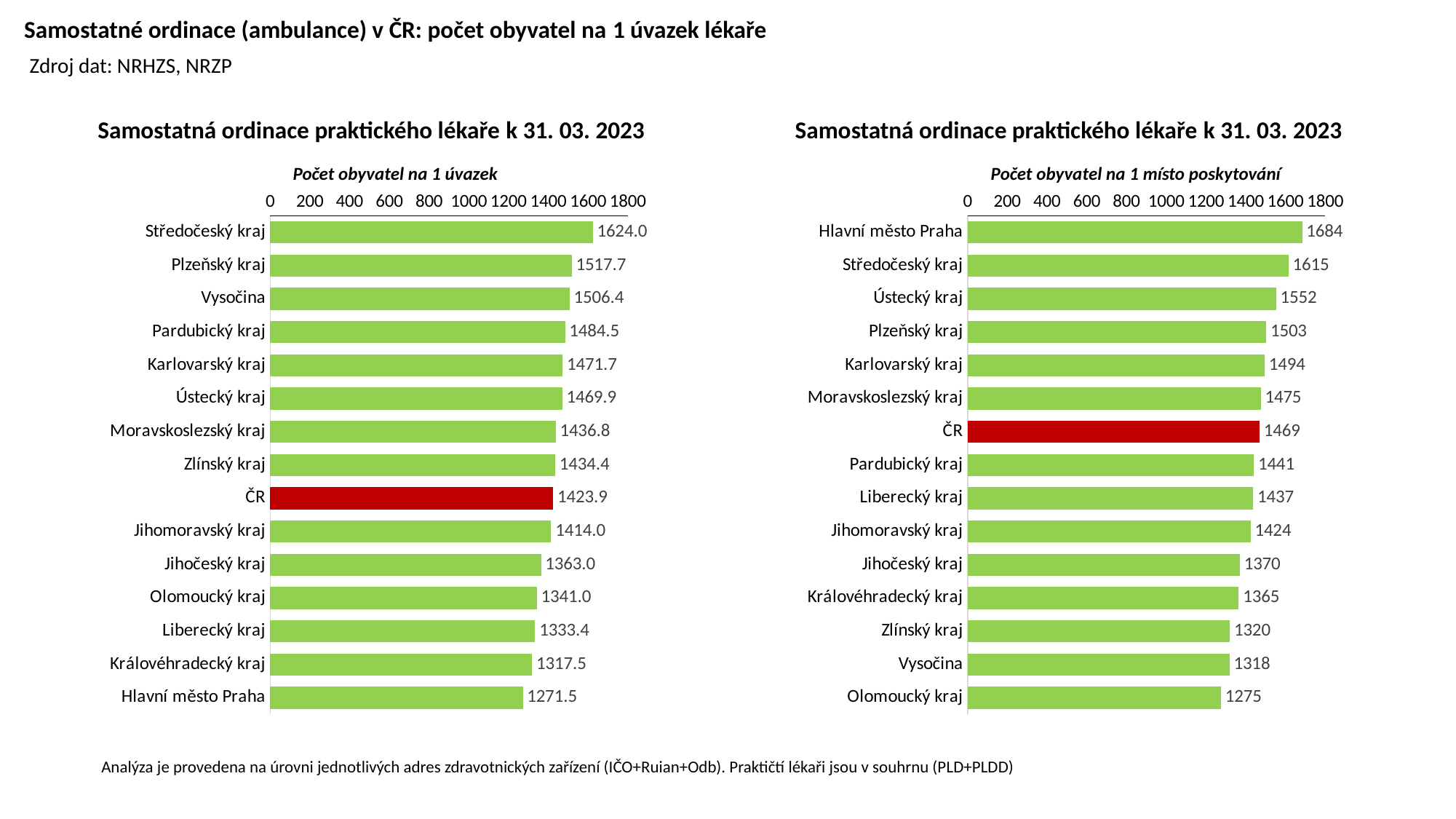
In the left chart (Počet obyvatel na 1 úvazek), what is the difference between Středočeský kraj and Hlavní město Praha? 352.5 In the left chart (Počet obyvatel na 1 úvazek), what is the value for ČR? 1423.9 In the right chart (Počet obyvatel na 1 místo poskytování), which category has the lowest value? Olomoucký kraj In the right chart (Počet obyvatel na 1 místo poskytování), what is the value for Hlavní město Praha? 1684 In the right chart (Počet obyvatel na 1 místo poskytování), which bar is coloured red instead of green? ČR In the right chart (Počet obyvatel na 1 místo poskytování), what is the difference between Hlavní město Praha and Olomoucký kraj? 409 What type of chart is the left chart (Počet obyvatel na 1 úvazek)? Bar chart In the left chart (Počet obyvatel na 1 úvazek), what is the value for Středočeský kraj? 1624.0 In the right chart (Počet obyvatel na 1 místo poskytování), which category has the highest value? Hlavní město Praha In the left chart (Počet obyvatel na 1 úvazek), which category has the lowest value? Hlavní město Praha In the left chart (Počet obyvatel na 1 úvazek), which is larger: Vysočina or Jihočeský kraj? Vysočina How many categories (bars) are shown in the right chart (Počet obyvatel na 1 místo poskytování)? 15